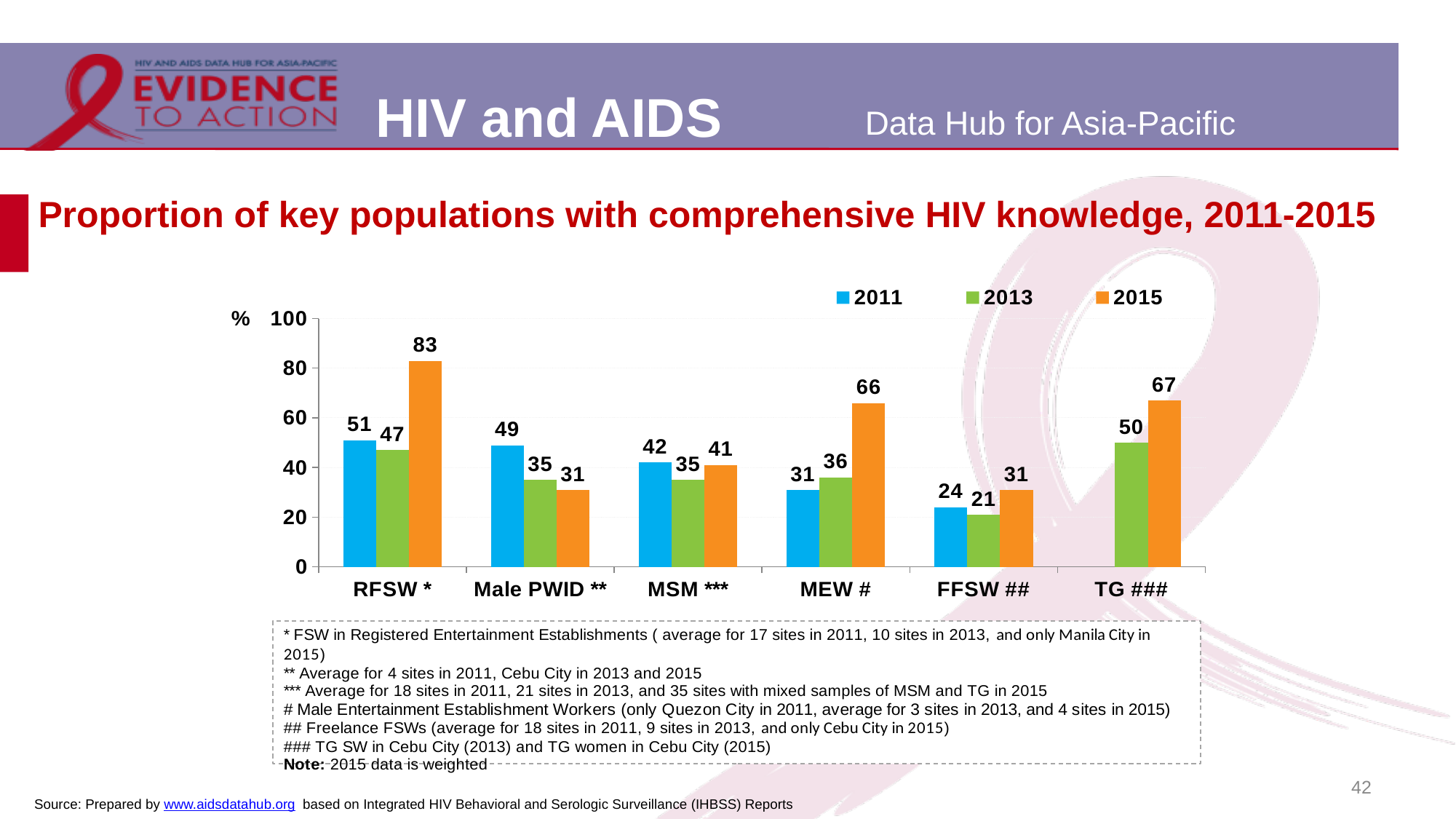
What kind of chart is shown on the slide? Bar chart What is the difference between the 2015 and 2011 values for MEW? 35 Which series is shown in orange in the legend? 2015 What is the 2015 value for RFSW? 83 What is the 2013 value for FFSW? 21 Which is larger for MSM: the 2011 value or the 2015 value? 2011 How many categories are shown on the x axis? 6 What is the 2011 value for Male PWID? 49 Which category has the highest 2015 value? RFSW Do the values for Male PWID rise or fall from 2011 to 2015? Fall Which category has the lowest 2011 value? FFSW How many series does the legend list? 3